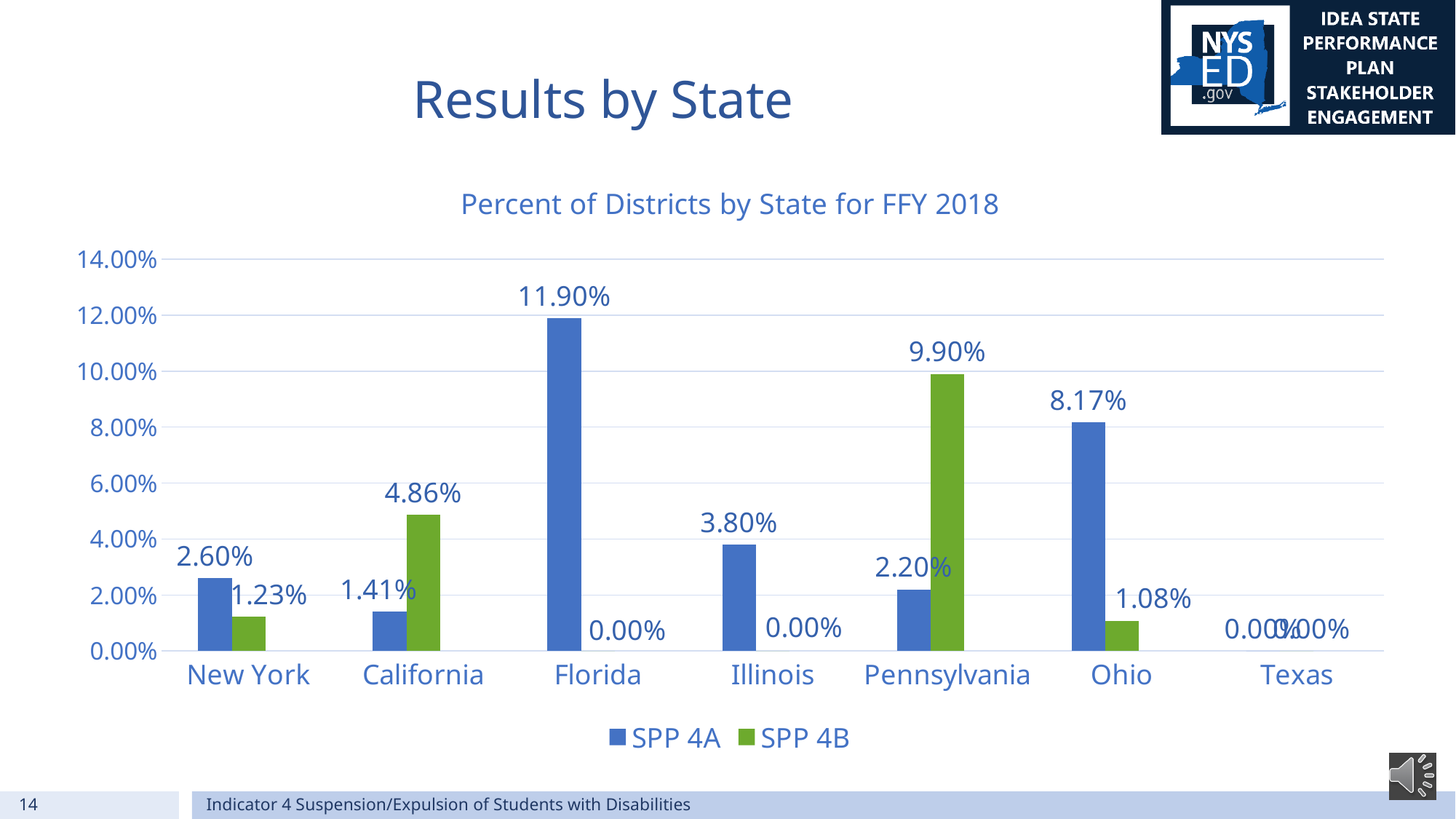
What type of chart is shown on the slide? bar chart What is the difference between the SPP 4A and SPP 4B values for New York? 1.37% Which state has the highest SPP 4A value? Florida What is the SPP 4B value for Pennsylvania? 9.90% What is the SPP 4A value for Florida? 11.90% Is the SPP 4A value for Illinois greater or less than 4.00%? less How many series does the legend list? 2 What is the SPP 4B value for California? 4.86% Which state has the highest SPP 4B value? Pennsylvania How many states are shown on the x axis? 7 For California, which is larger, SPP 4A or SPP 4B? SPP 4B What is the SPP 4A value for Ohio? 8.17%